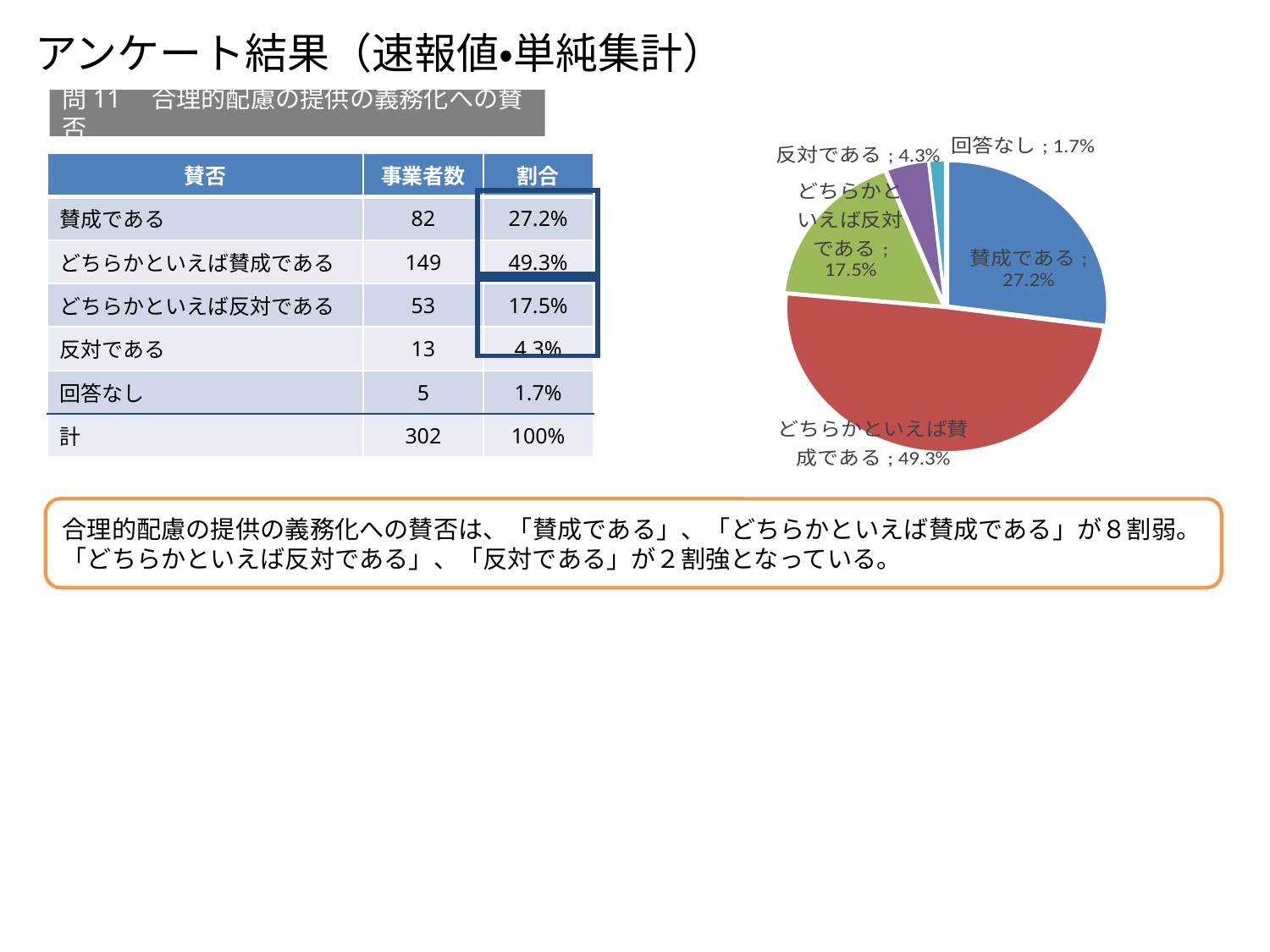
In the pie chart, what share is labelled for 回答なし? 1.7% What kind of chart is shown on the slide? pie chart In the pie chart, which is larger: 賛成である or どちらかといえば反対である? 賛成である In the pie chart, what share is labelled for どちらかといえば賛成である? 49.3% In the pie chart, what share is labelled for 賛成である? 27.2% How many slices does the pie chart have? 5 In the pie chart, what share is labelled for 反対である? 4.3% What colour is the どちらかといえば賛成である slice in the pie chart? red Which slice of the pie chart is the smallest? 回答なし In the pie chart, what is the difference in percentage points between どちらかといえば賛成である and 賛成である? 22.1 In the pie chart, what share is labelled for どちらかといえば反対である? 17.5% Which slice of the pie chart is the largest? どちらかといえば賛成である